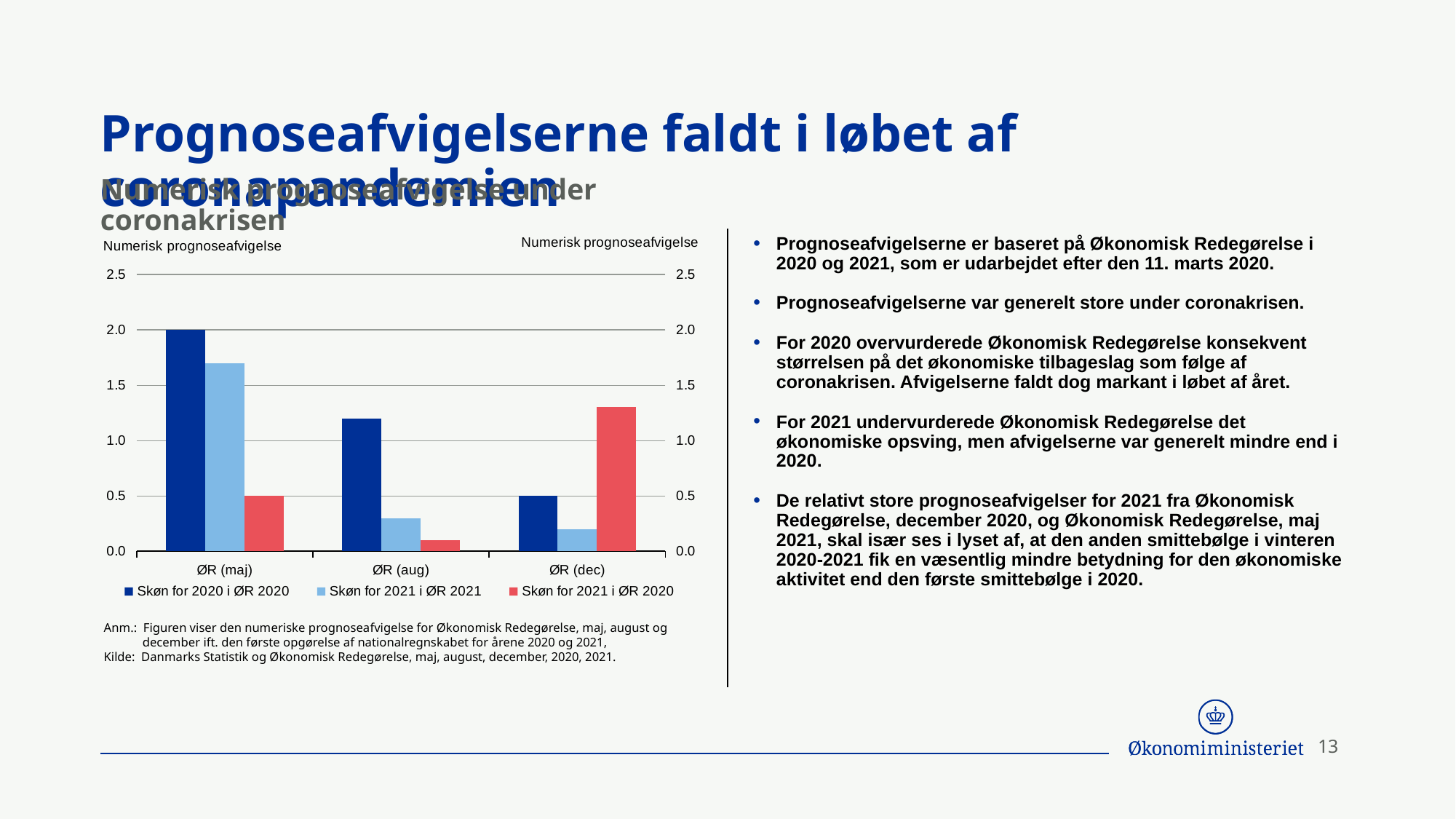
How many series does the chart's legend list? 3 Is the value of 'Skøn for 2021 i ØR 2020' for ØR (dec) greater or less than 1.0? greater Which series has the largest value in the ØR (dec) category? Skøn for 2021 i ØR 2020 What is the value of 'Skøn for 2020 i ØR 2020' for ØR (maj)? 2.0 Is the value of 'Skøn for 2021 i ØR 2021' for ØR (maj) greater or less than 1.5? greater What kind of chart is shown on the slide? bar chart How many categories are shown on the x axis of the chart? 3 What is the value of 'Skøn for 2020 i ØR 2020' for ØR (dec)? 0.5 Does the 'Skøn for 2020 i ØR 2020' series rise or fall from ØR (maj) to ØR (dec)? fall Is the value of 'Skøn for 2021 i ØR 2021' for ØR (aug) greater or less than 0.5? less What is the value of 'Skøn for 2021 i ØR 2020' for ØR (maj)? 0.5 Which category has the highest value for 'Skøn for 2020 i ØR 2020'? ØR (maj)